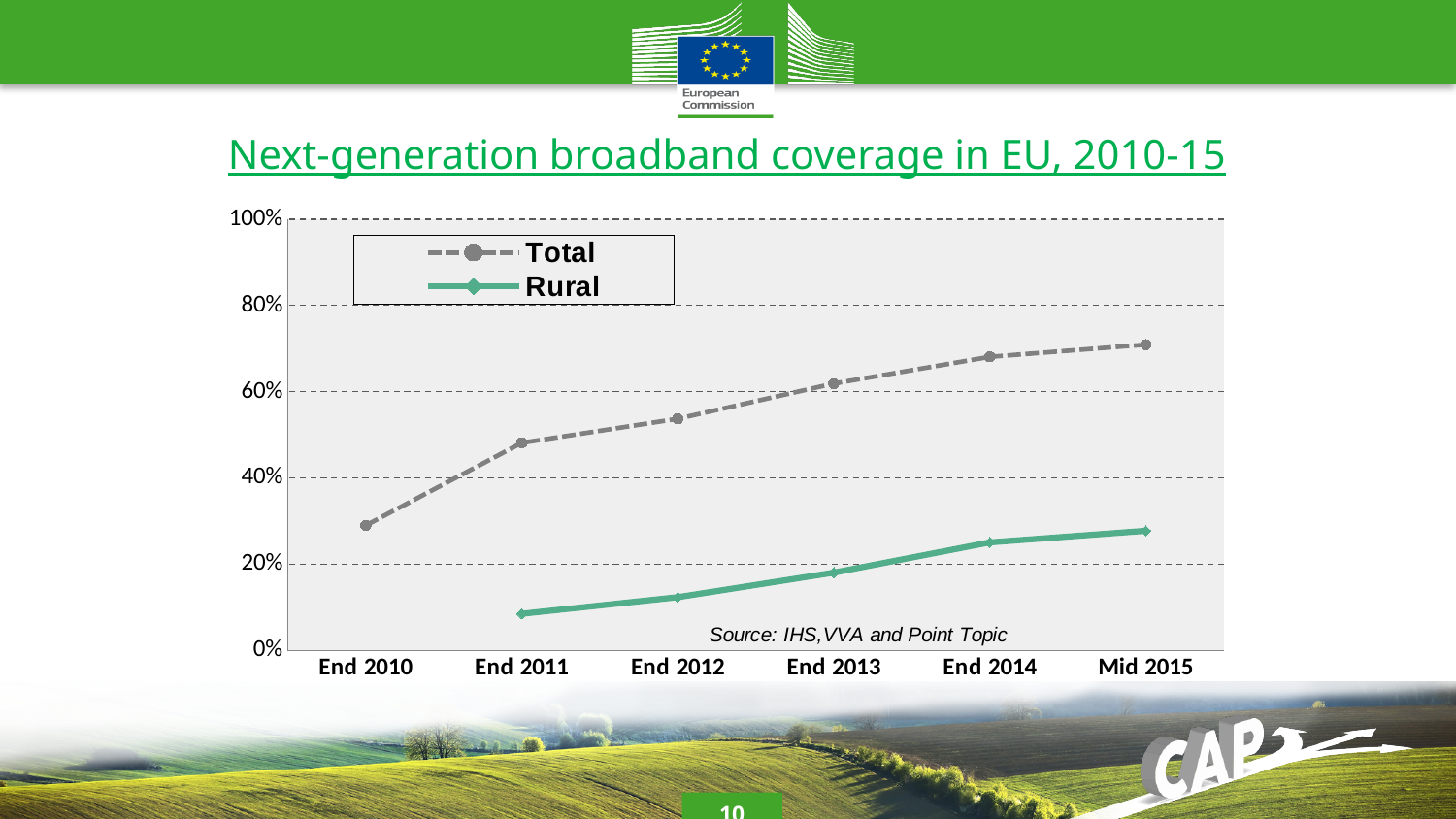
At which time point is the Total series lowest? End 2010 Is the value for Rural at End 2011 greater or less than 20%? less Is the value for Total at End 2011 greater or less than 40%? greater How many series does the legend list? 2 At End 2014, which series has the larger value, Total or Rural? Total Do the Rural values rise or fall from End 2011 to Mid 2015? rise How many time points are labelled on the x axis? 6 Is the value for Total at Mid 2015 greater or less than 60%? greater At which time point is the Total series highest? Mid 2015 What kind of chart is shown on the slide? line chart